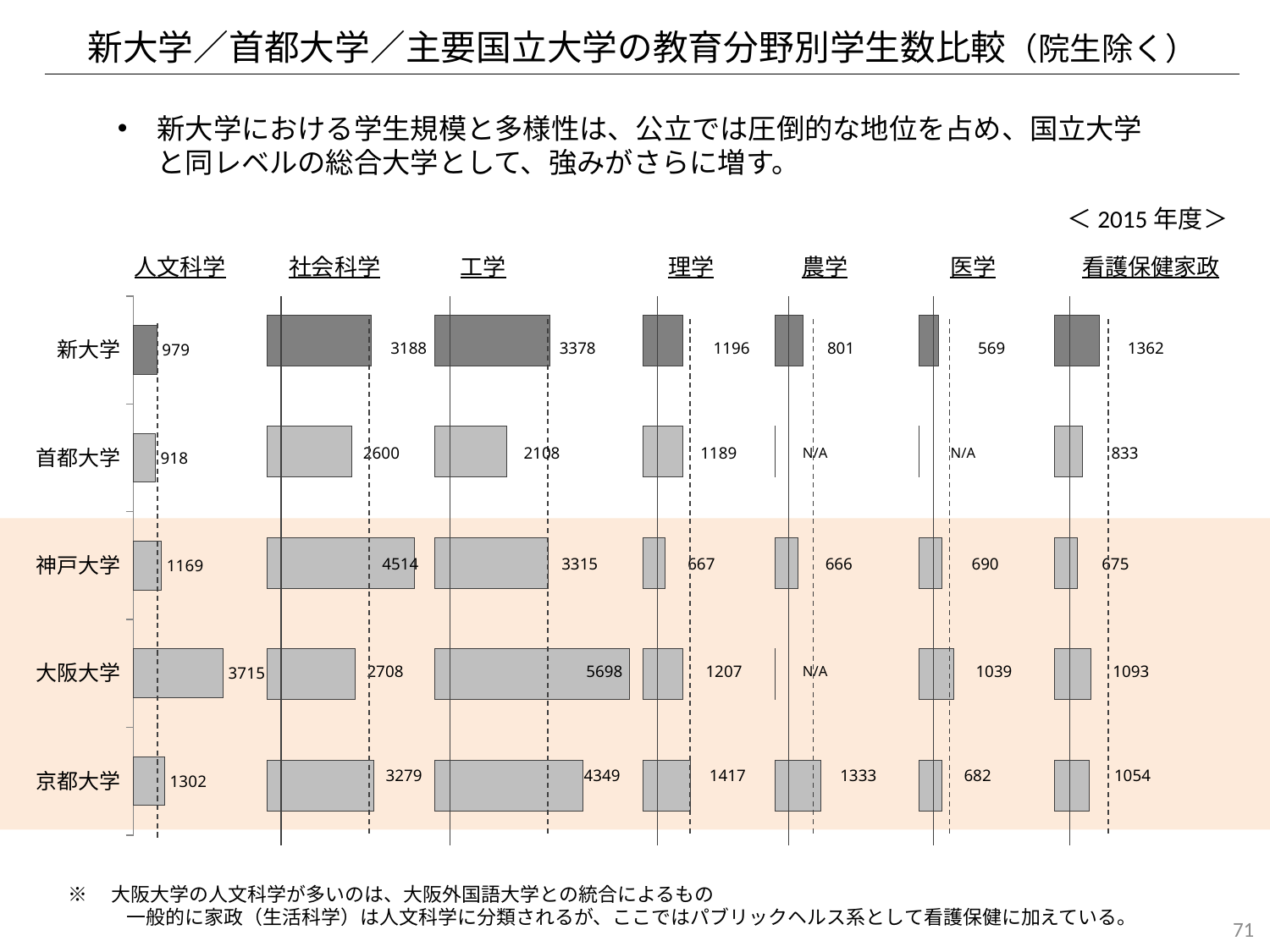
In the 工学 chart, which university has the highest value? 大阪大学 In the 看護保健家政 chart, which university has the lowest value? 神戸大学 What is the value for 新大学 in the 工学 chart? 3378 In the 社会科学 chart, what is the difference between the values for 新大学 and 首都大学? 588 What is the value for 京都大学 in the 理学 chart? 1417 What kind of chart is used on this slide? Bar chart In the 人文科学 chart, which is larger: the value for 大阪大学 or for 京都大学? 大阪大学 In the 社会科学 chart, which university has the highest value? 神戸大学 How many education fields (charts) are shown on the slide? 7 In the 農学 chart, which universities are shown as N/A? 首都大学 and 大阪大学 What is the value for 神戸大学 in the 農学 chart? 666 How many universities are compared in the charts? 5